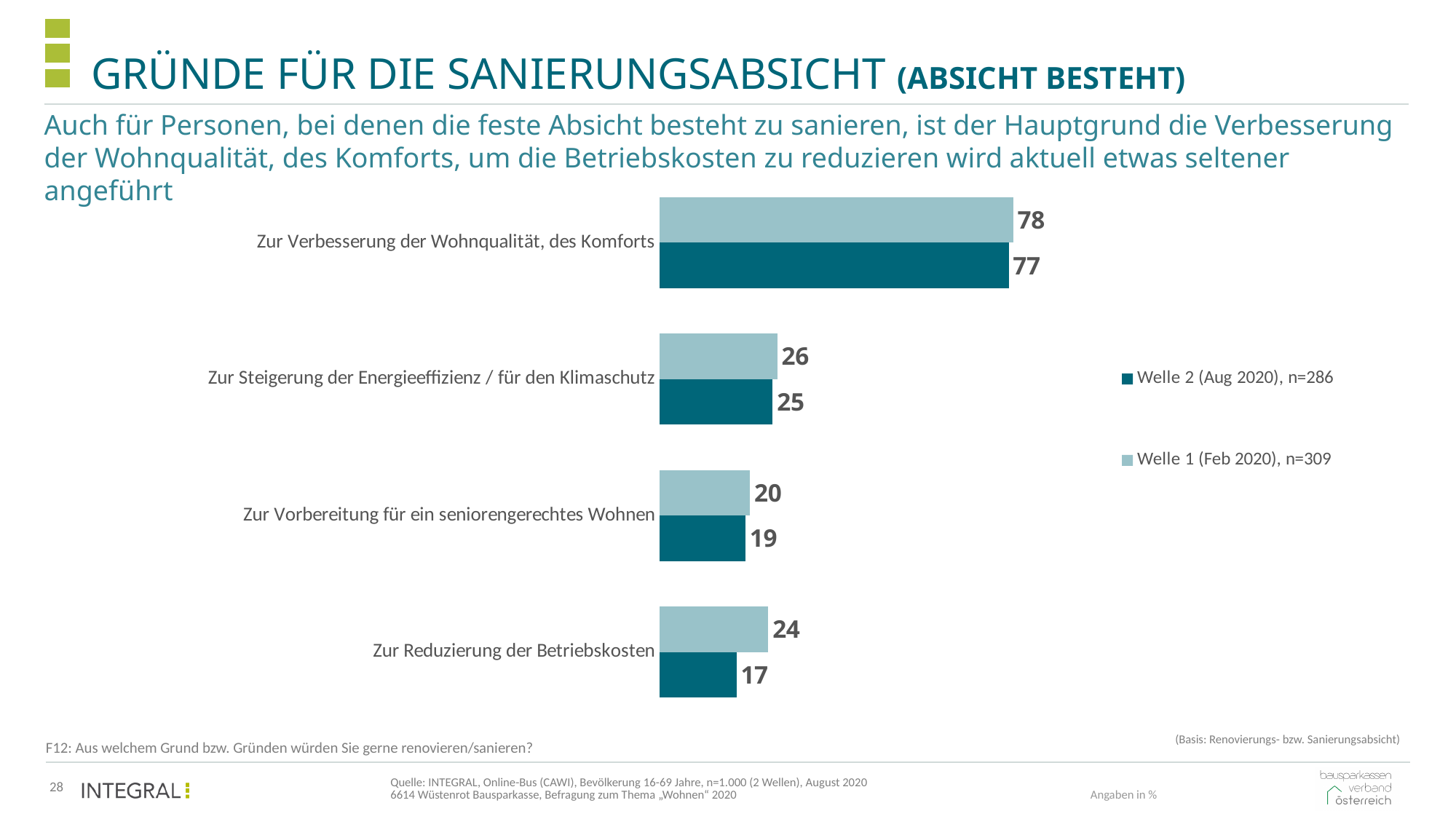
What is the difference between the Welle 1 and Welle 2 values for 'Zur Reduzierung der Betriebskosten'? 7 What is the value for 'Zur Vorbereitung für ein seniorengerechtes Wohnen' in Welle 2 (Aug 2020)? 19 How many categories are shown in the chart? 4 What is the value for 'Zur Reduzierung der Betriebskosten' in Welle 1 (Feb 2020)? 24 Which category has the lowest value in Welle 2 (Aug 2020)? Zur Reduzierung der Betriebskosten Which is larger for 'Zur Reduzierung der Betriebskosten': the Welle 1 (Feb 2020) value or the Welle 2 (Aug 2020) value? Welle 1 (Feb 2020) What is the sample size (n) for Welle 2 (Aug 2020) according to the legend? n=286 How many series does the legend list? 2 What kind of chart is shown on the slide? Bar chart What is the value for 'Zur Verbesserung der Wohnqualität, des Komforts' in Welle 2 (Aug 2020)? 77 What is the value for 'Zur Steigerung der Energieeffizienz / für den Klimaschutz' in Welle 1 (Feb 2020)? 26 Which category has the highest value in Welle 2 (Aug 2020)? Zur Verbesserung der Wohnqualität, des Komforts